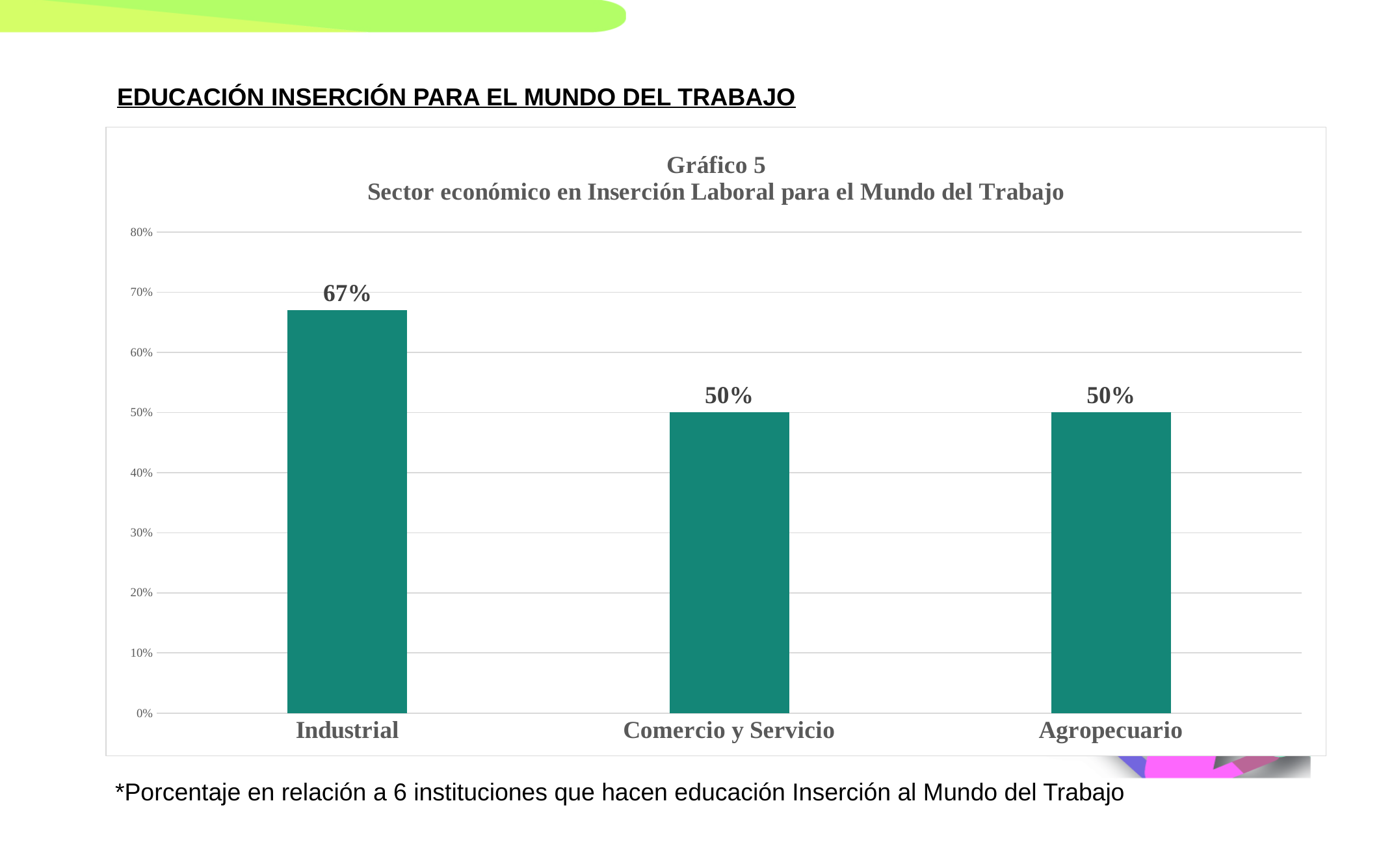
What is the difference between the values for Industrial and Comercio y Servicio? 17% What is the value for Industrial? 67% What kind of chart is shown on the slide? bar chart How many categories are shown on the chart? 3 What is the value for Agropecuario? 50% Which category has the highest value? Industrial Is the value for Agropecuario greater or less than 60%? less Which is larger, the value for Industrial or the value for Agropecuario? Industrial What is the value for Comercio y Servicio? 50% What is the title of the chart? Gráfico 5 Sector económico en Inserción Laboral para el Mundo del Trabajo What is the highest value shown on the vertical axis? 80% Is the value for Industrial greater or less than 60%? greater